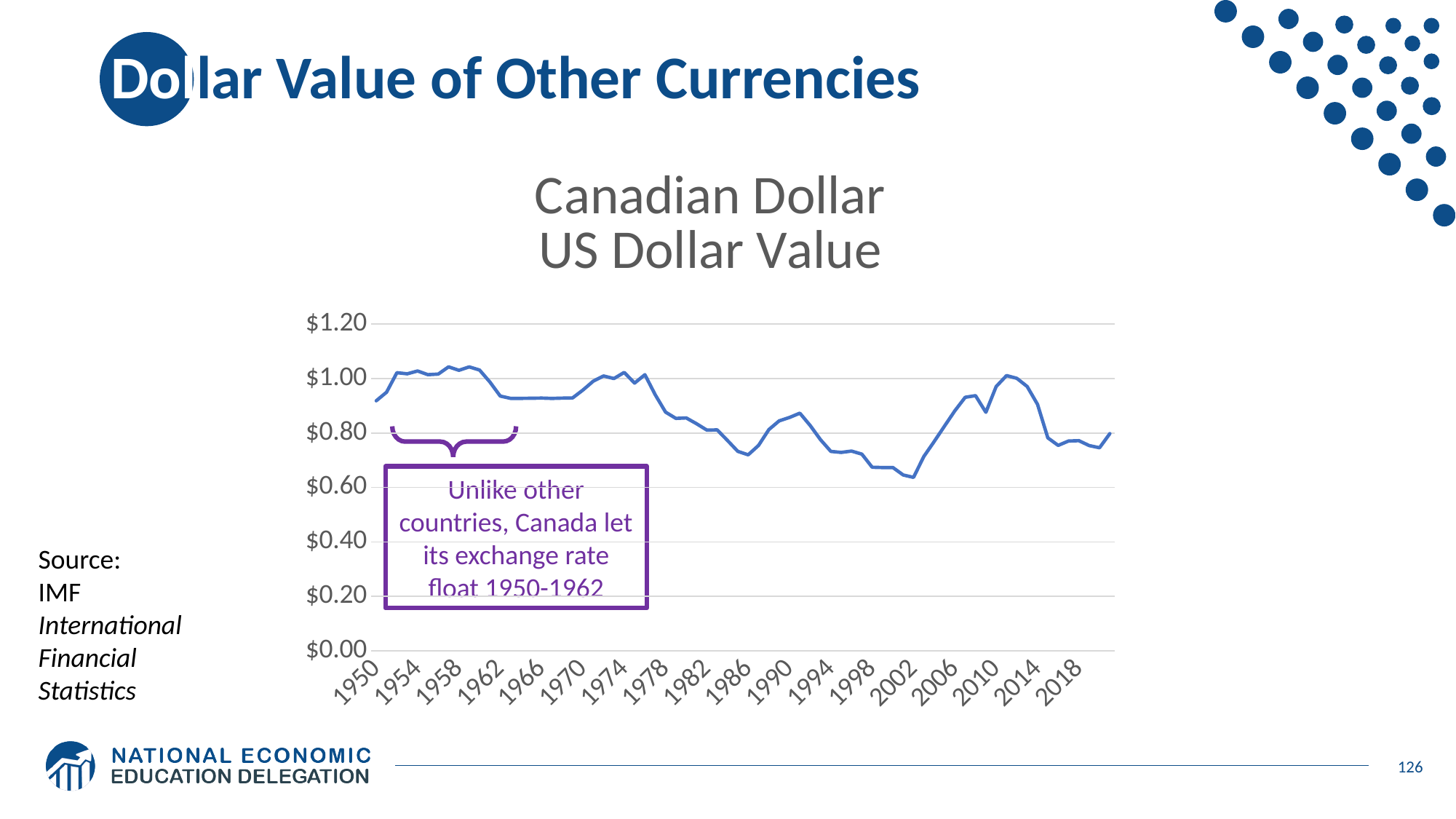
Is the value for 2010 greater or less than $0.80? greater Is the value for 2002 greater or less than $0.60? greater Which labelled year on the x axis has the lowest value? 2002 Is the value for 1986 greater or less than $0.80? less What is the title of the chart? Canadian Dollar US Dollar Value What kind of chart is shown on the slide? line chart How many year labels are shown on the x axis? 18 How many lines are plotted on the chart? 1 Does the value rise or fall between 2002 and 2010? rise Does the value rise or fall between 1974 and 1986? fall